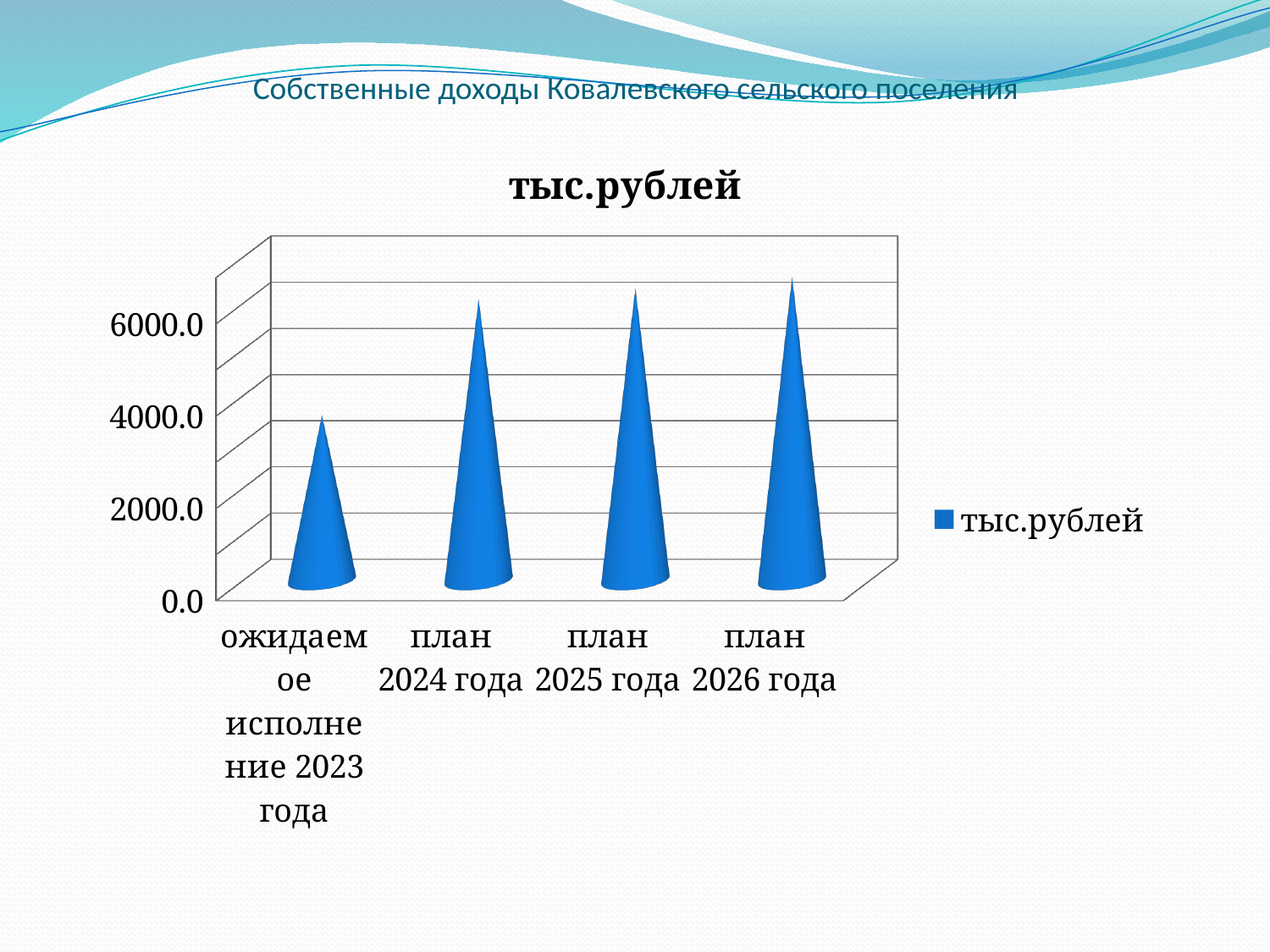
Is the value for ожидаемое исполнение 2023 года greater or less than 2000.0? greater Is the value for план 2026 года greater or less than 6000.0? greater How many categories are shown on the x axis of the chart? 4 What is the title of the chart? тыс.рублей Is the value for план 2024 года greater or less than 4000.0? greater What entry is listed in the chart legend? тыс.рублей Which category has the lowest value in the chart? ожидаемое исполнение 2023 года Do the values rise or fall from left to right along the x axis? rise Which is larger: the value for ожидаемое исполнение 2023 года or the value for план 2024 года? план 2024 года What kind of chart is shown on the slide? bar chart Which category has the highest value in the chart? план 2026 года How many series does the chart legend list? 1